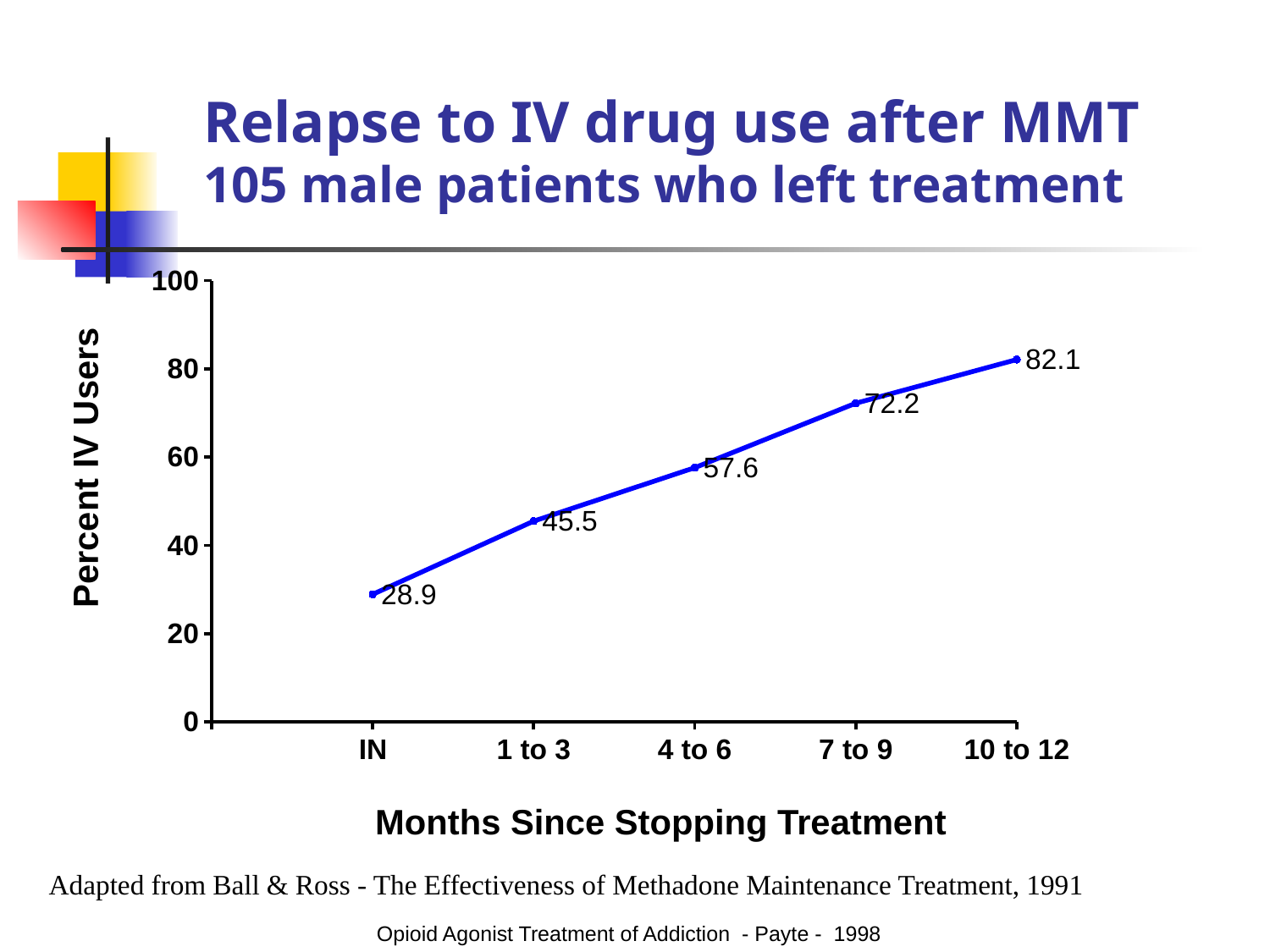
What is the percent of IV users at 1 to 3 months since stopping treatment? 45.5 What is the percent of IV users at 4 to 6 months since stopping treatment? 57.6 Which x-axis category has the highest percent of IV users? 10 to 12 What is the difference in percent IV users between 10 to 12 months and IN? 53.2 What is the difference in percent IV users between 7 to 9 months and 4 to 6 months? 14.6 What is the percent of IV users at the 'IN' point? 28.9 How many data points are plotted on the line? 5 What kind of chart is shown on the slide? line chart What is the percent of IV users at 10 to 12 months since stopping treatment? 82.1 Which is larger, the percent of IV users at 1 to 3 months or at 7 to 9 months? 7 to 9 Which x-axis category has the lowest percent of IV users? IN Do the values rise or fall as months since stopping treatment increase? rise